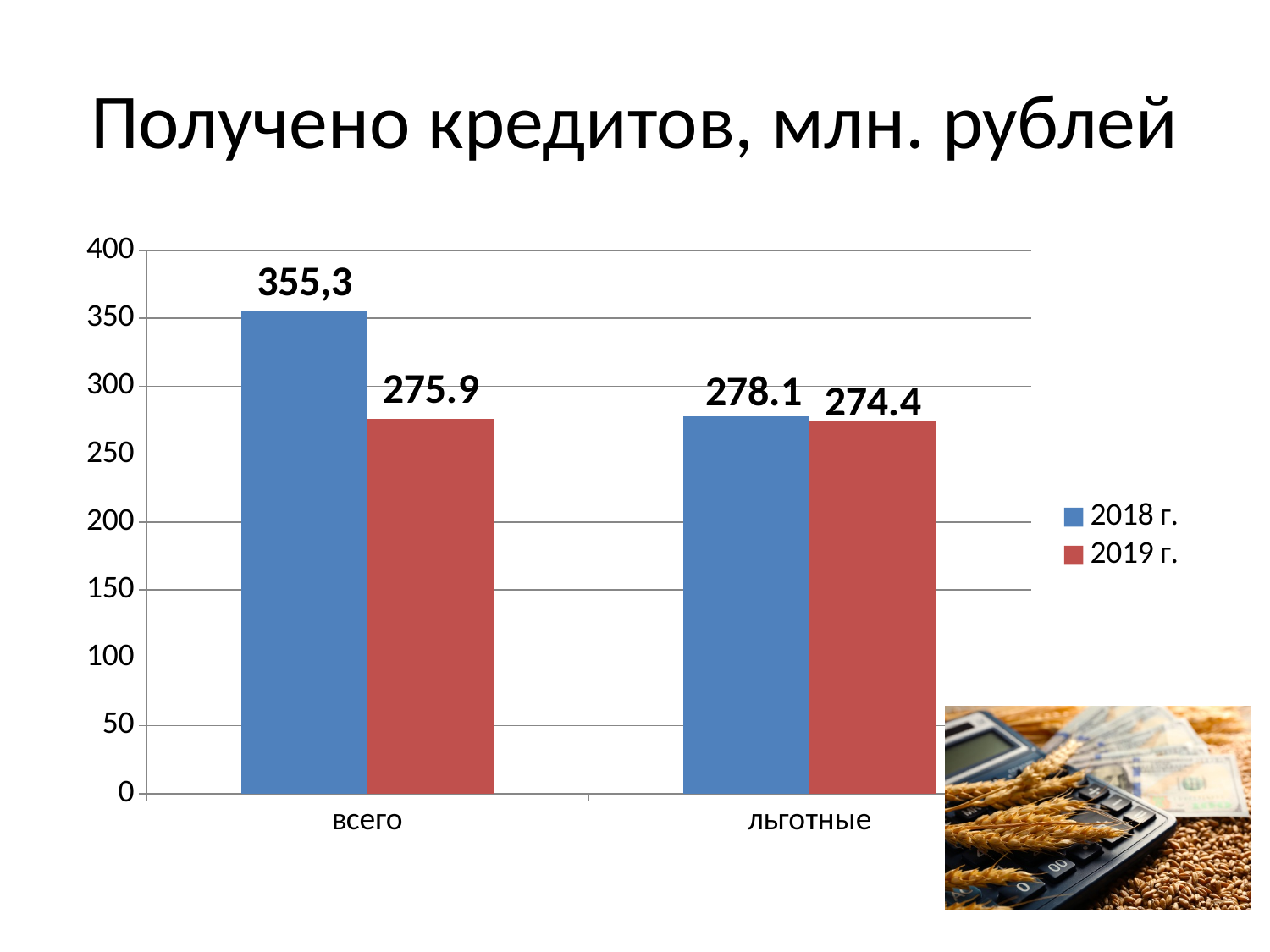
Which is larger in the льготные category: the 2018 г. value or the 2019 г. value? 2018 г. What is the value for 2019 г. in the всего category? 275.9 What is the value for 2018 г. in the льготные category? 278.1 What is the value for 2018 г. in the всего category? 355,3 How many categories are shown on the x axis? 2 What is the title of the slide? Получено кредитов, млн. рублей What is the difference between the 2018 г. and 2019 г. values in the всего category? 79.4 Which bar has the highest value on the chart? 2018 г., всего What is the value for 2019 г. in the льготные category? 274.4 How many series does the legend list? 2 What is the difference between the 2018 г. and 2019 г. values in the льготные category? 3.7 Which bar has the lowest value on the chart? 2019 г., льготные